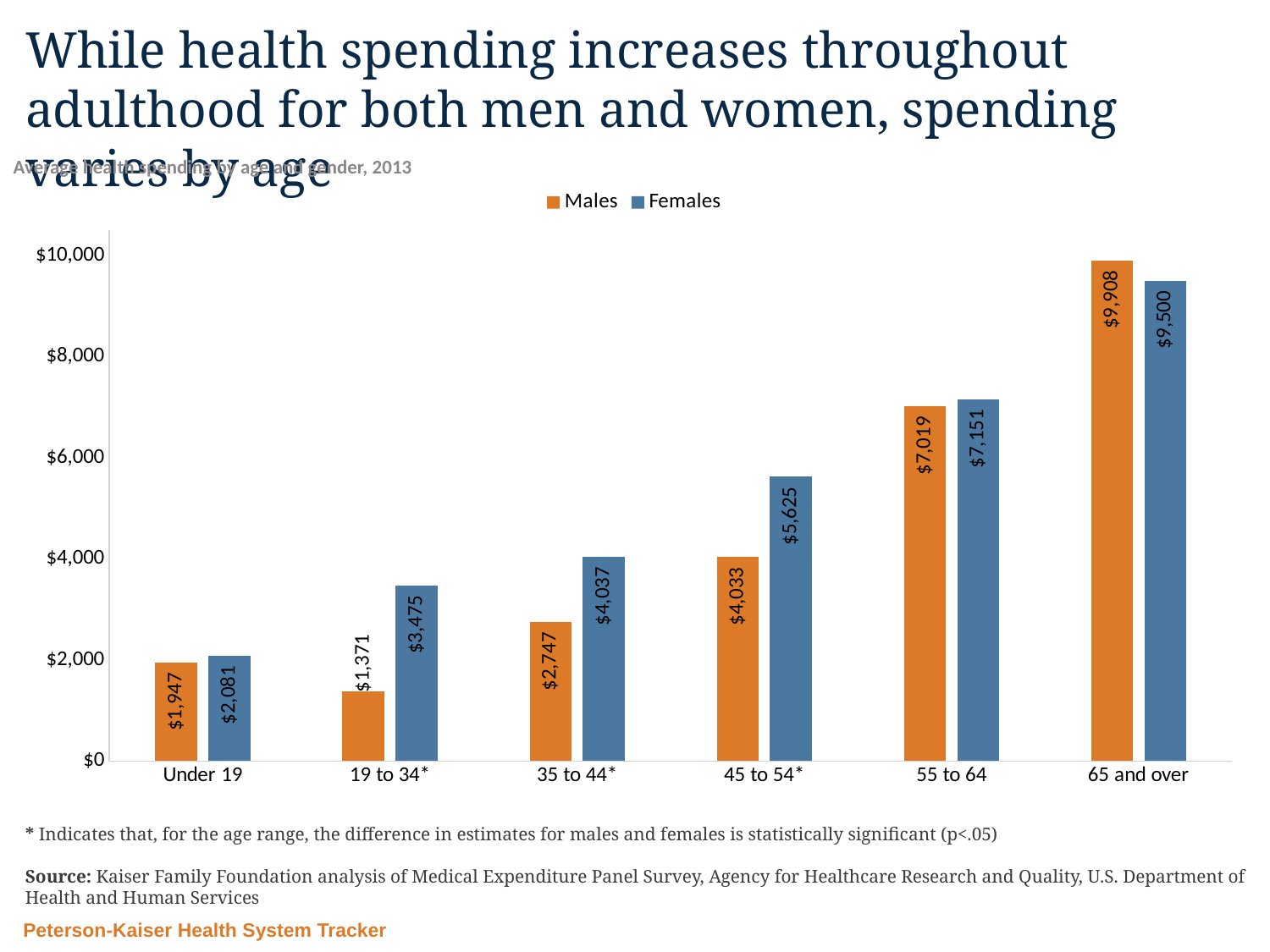
What is the average health spending for females aged 19 to 34? $3,475 Which age group has the highest average health spending for males? 65 and over How many age groups are shown on the x axis? 6 What is the average health spending for males aged 45 to 54? $4,033 Is the average health spending for females aged 45 to 54 greater or less than $6,000? less Which age group has the lowest average health spending for males? 19 to 34* How many series does the legend list? 2 Which colour represents Females in the chart? Blue What is the average health spending for females aged 65 and over? $9,500 What is the difference between female and male average health spending in the 19 to 34 age group? $2,104 What type of chart is shown on the slide? Bar chart In the 65 and over age group, is average health spending higher for males or females? Males